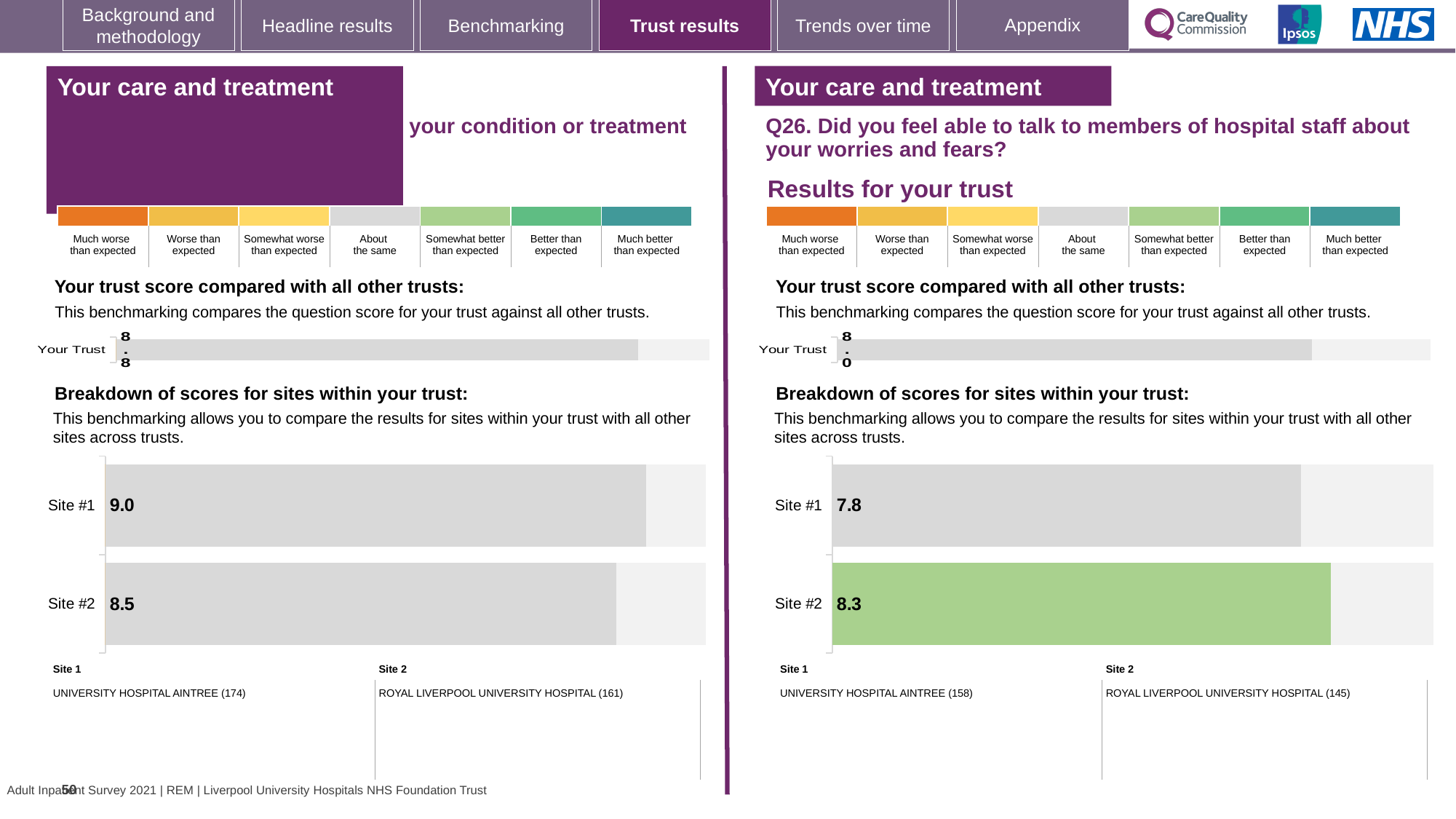
On the right-hand side of the slide (Q26), what is the score for Site #2 in the breakdown of scores for sites within your trust? 8.3 On the right-hand side of the slide (Q26), what is the score for Site #1 in the breakdown of scores for sites within your trust? 7.8 On the left-hand side of the slide, what is the score for Site #2 in the breakdown of scores for sites within your trust? 8.5 What type of chart is used for the breakdown of scores for sites within your trust on the left-hand side of the slide? Bar chart On the right-hand side of the slide (Q26), which site has the lower score in the breakdown of scores for sites within your trust? Site #1 On the left-hand side of the slide, which site has the higher score in the breakdown of scores for sites within your trust? Site #1 On the left-hand side of the slide, what is the score for Site #1 in the breakdown of scores for sites within your trust? 9.0 On the right-hand side of the slide (Q26), what is the difference between the Site #2 and Site #1 scores in the site breakdown chart? 0.5 On the right-hand side of the slide (Q26), what is the 'Your Trust' score shown in the trust score comparison chart? 8.0 On the left-hand side of the slide, what is the 'Your Trust' score shown in the trust score comparison chart? 8.8 On the left-hand side of the slide, what is the difference between the Site #1 and Site #2 scores in the site breakdown chart? 0.5 How many sites are shown in the breakdown of scores chart on the right-hand side of the slide (Q26)? 2